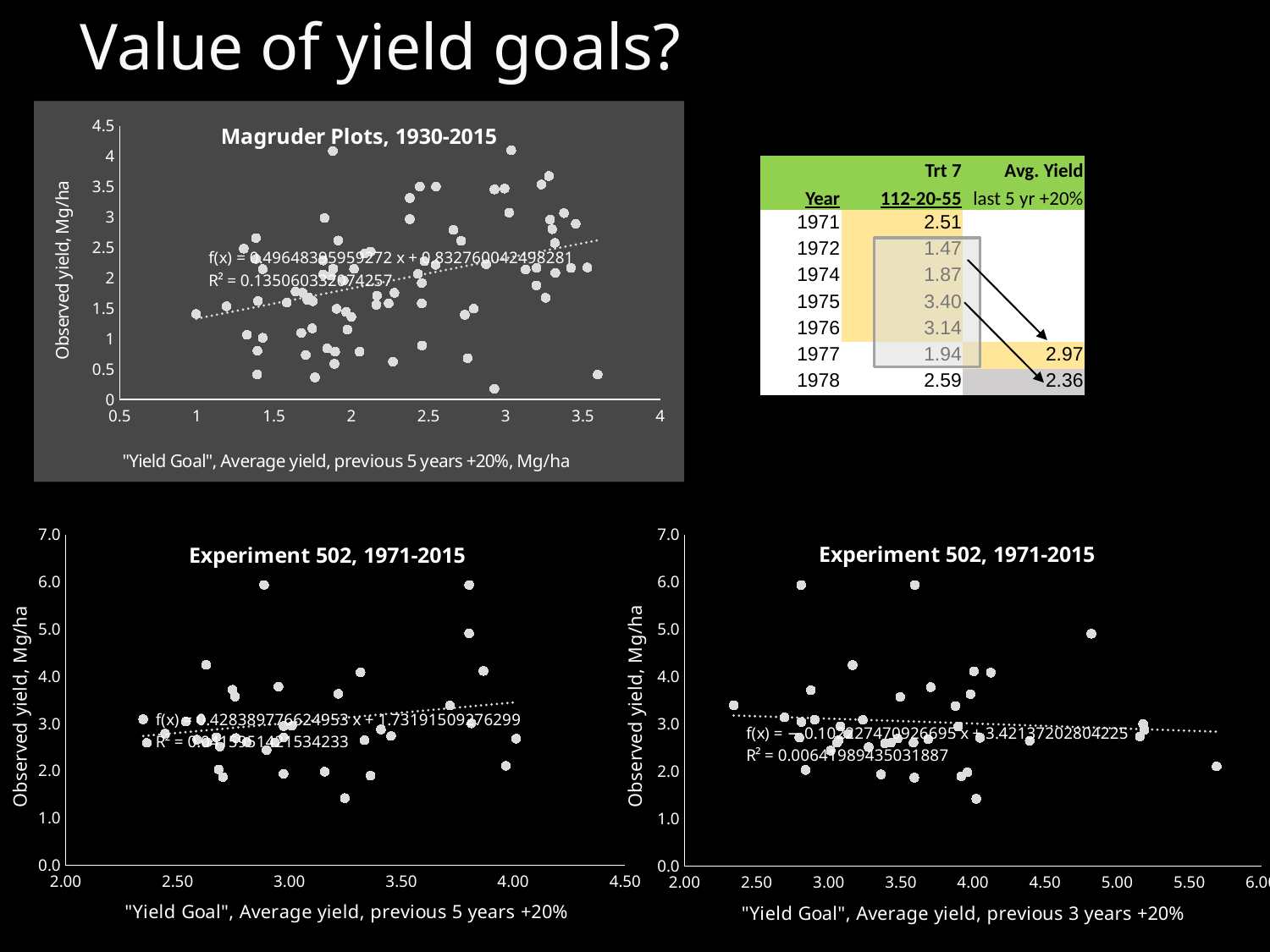
In the bottom-right 'Experiment 502, 1971-2015' chart, is the highest observed yield greater or less than 5.0? greater In the bottom-left 'Experiment 502, 1971-2015' chart (previous 5 years), does the fitted trendline rise or fall as the yield goal increases? rises In the 'Magruder Plots, 1930-2015' chart, is the highest observed yield greater or less than 3.5? greater How many scatter charts are shown on the slide? 3 What R² value is printed on the 'Magruder Plots, 1930-2015' chart? 0.135060352074257 What is the x-axis label of the bottom-right 'Experiment 502, 1971-2015' chart? "Yield Goal", Average yield, previous 3 years +20% What is the title of the top-left chart? Magruder Plots, 1930-2015 In the bottom-left 'Experiment 502, 1971-2015' chart, is the lowest observed yield greater or less than 2.0? less What kind of chart is the 'Magruder Plots, 1930-2015' chart? scatter chart In the bottom-right 'Experiment 502, 1971-2015' chart (previous 3 years), does the fitted trendline rise or fall as the yield goal increases? falls In the 'Magruder Plots, 1930-2015' chart, does the fitted trendline rise or fall as the yield goal increases? rises